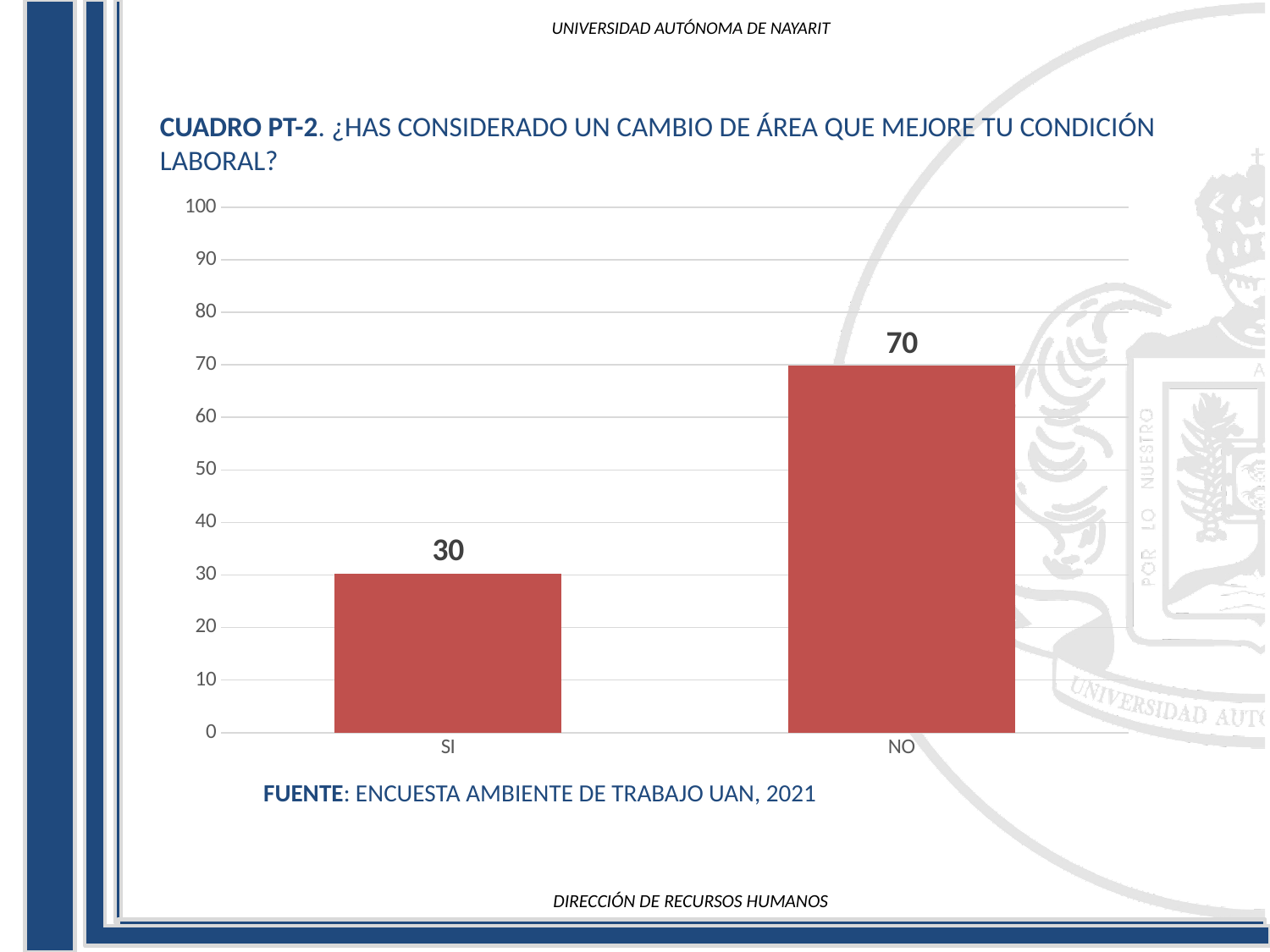
What is the value for SI? 30 How many categories are shown on the x axis? 2 What kind of chart is shown on the slide? bar chart Is the value for NO greater or less than 60? greater What is the total of the two bars? 100 Is the value for SI greater or less than 40? less What is the difference between the values for NO and SI? 40 What is the value for NO? 70 Which category has the lowest value? SI Which is larger, the value for SI or the value for NO? NO Which category has the highest value? NO What source is cited below the chart? ENCUESTA AMBIENTE DE TRABAJO UAN, 2021